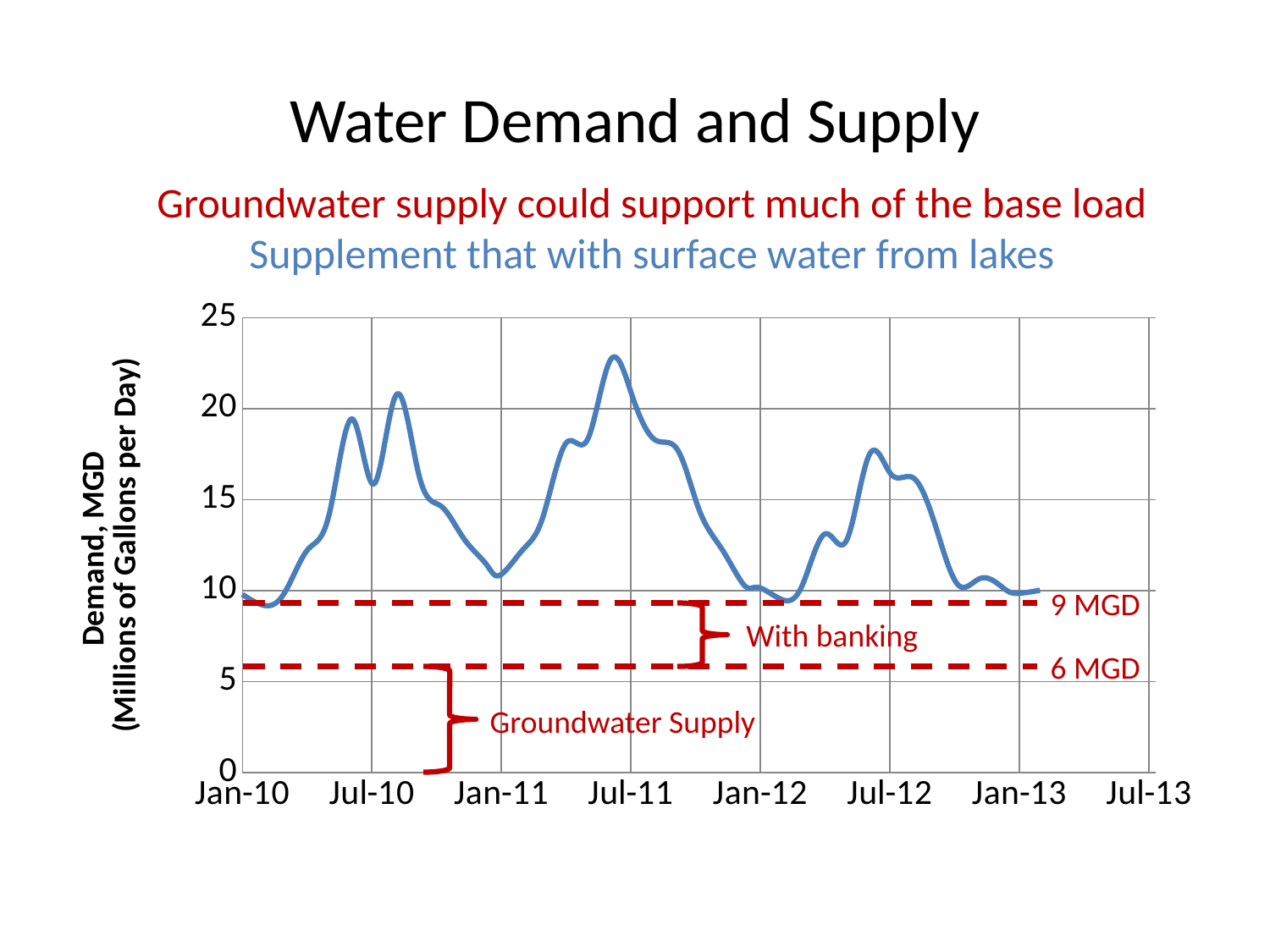
What is the label of the vertical axis? Demand, MGD (Millions of Gallons per Day) Does demand rise or fall between Jul-11 and Jan-12? fall At what value is the upper dashed line, reached "With banking", drawn? 9 MGD Is the demand value at Jan-12 greater or less than 15? less How many tick labels are shown on the horizontal axis? 8 In which year does the demand line reach its highest peak? 2011 Which summer peak is higher, the one in 2011 or the one in 2012? 2011 Is the peak demand value around Jul-12 greater or less than 20? less At what value is the dashed line labelled "Groundwater Supply" drawn? 6 MGD What is the title of the chart on the slide? Water Demand and Supply Is the peak demand value around Jul-11 greater or less than 20? greater What kind of chart is shown on the slide? line chart